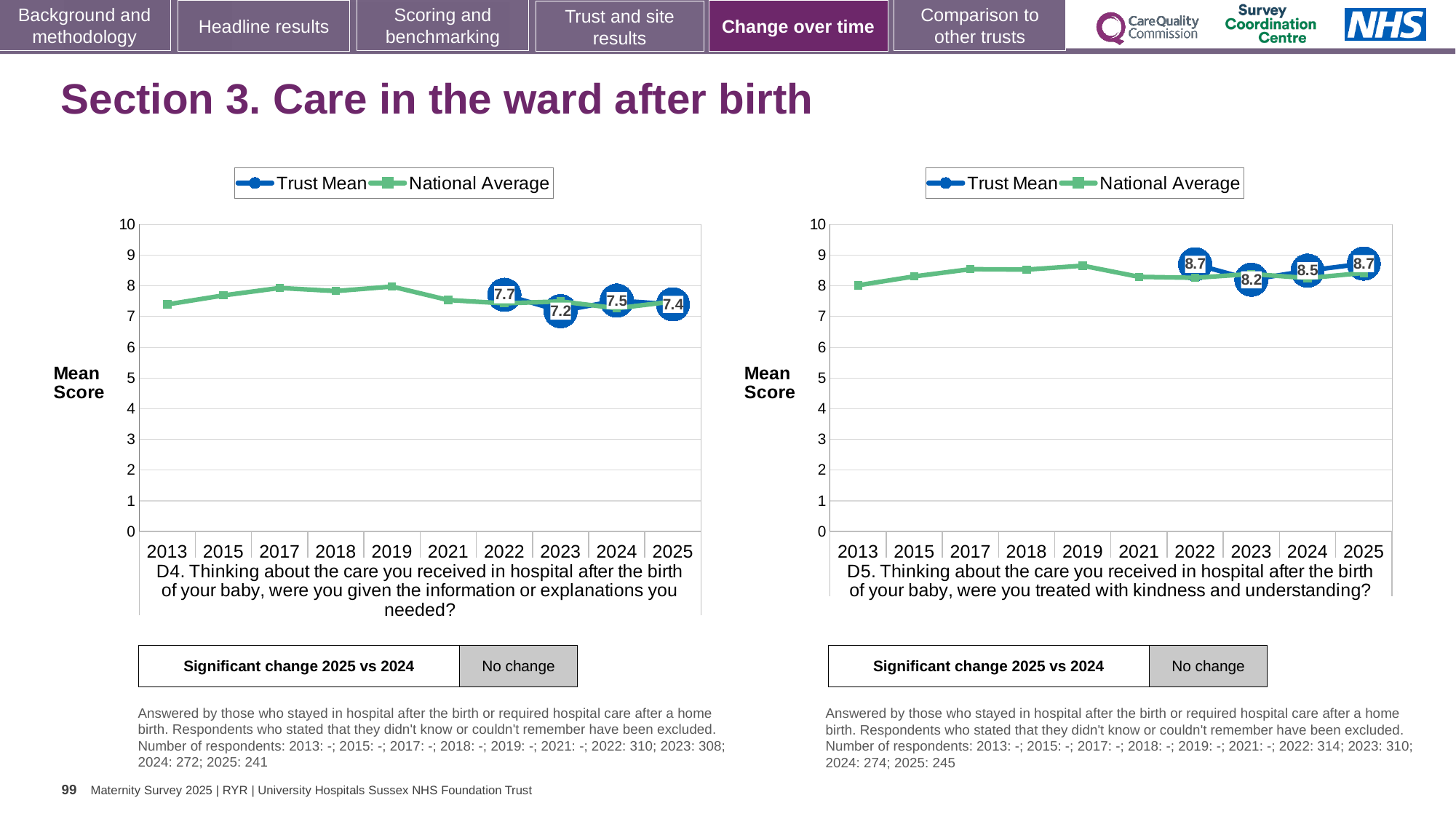
What kind of chart is the left chart (D4)? line chart In the left chart (D4), which year has the lowest labelled Trust Mean? 2023 In the right chart (D5), which year has the lowest labelled Trust Mean? 2023 In the left chart (D4), is the Trust Mean for 2024 or 2025 larger? 2024 In the left chart (D4), what is the Trust Mean for 2023? 7.2 In the right chart (D5), what is the Trust Mean for 2025? 8.7 In the left chart (D4), what is the difference between the Trust Mean for 2022 and 2023? 0.5 In the left chart (D4), what is the Trust Mean for 2022? 7.7 How many series does the legend of the right chart (D5) list? 2 In the right chart (D5), what is the Trust Mean for 2023? 8.2 In the left chart (D4), is the National Average for 2013 greater or less than 8? less In the right chart (D5), what is the difference between the Trust Mean for 2025 and 2024? 0.2